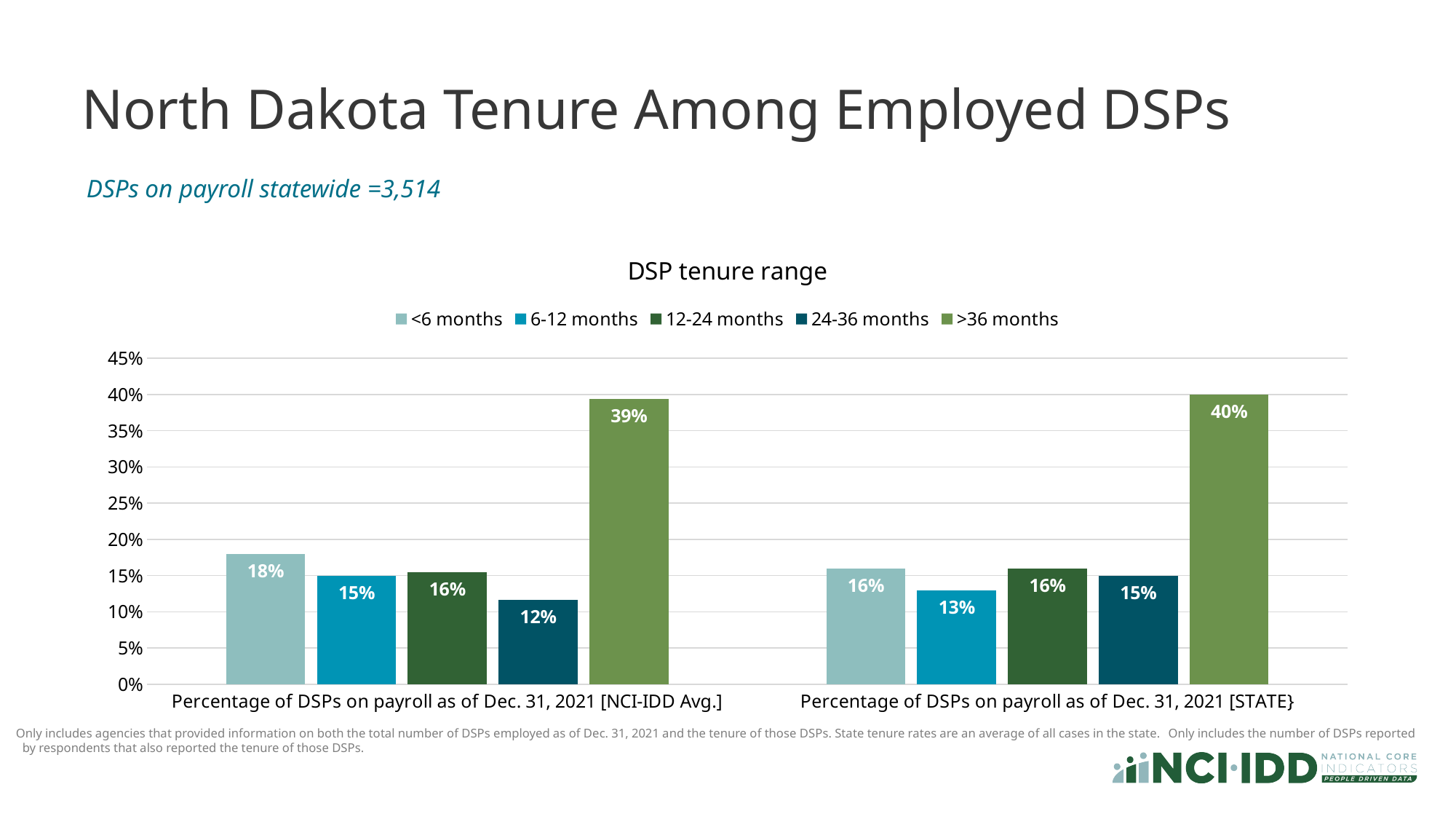
How many series does the legend list? 5 Which tenure range has the lowest value in the NCI-IDD Avg. group? 24-36 months Is the value for >36 months in the [STATE} group greater or less than 35%? greater What is the value for 6-12 months in the [STATE} group? 13% What is the value for >36 months in the NCI-IDD Avg. group? 39% What is the difference between the >36 months values for the [STATE} group and the NCI-IDD Avg. group? 1% What is the value for 24-36 months in the NCI-IDD Avg. group? 12% What kind of chart is shown on the slide? Bar chart Which is larger: the <6 months value for the NCI-IDD Avg. group or for the [STATE} group? NCI-IDD Avg. Which tenure range has the highest value in the [STATE} group? >36 months How many category groups are shown on the x axis? 2 What is the title of the chart? DSP tenure range